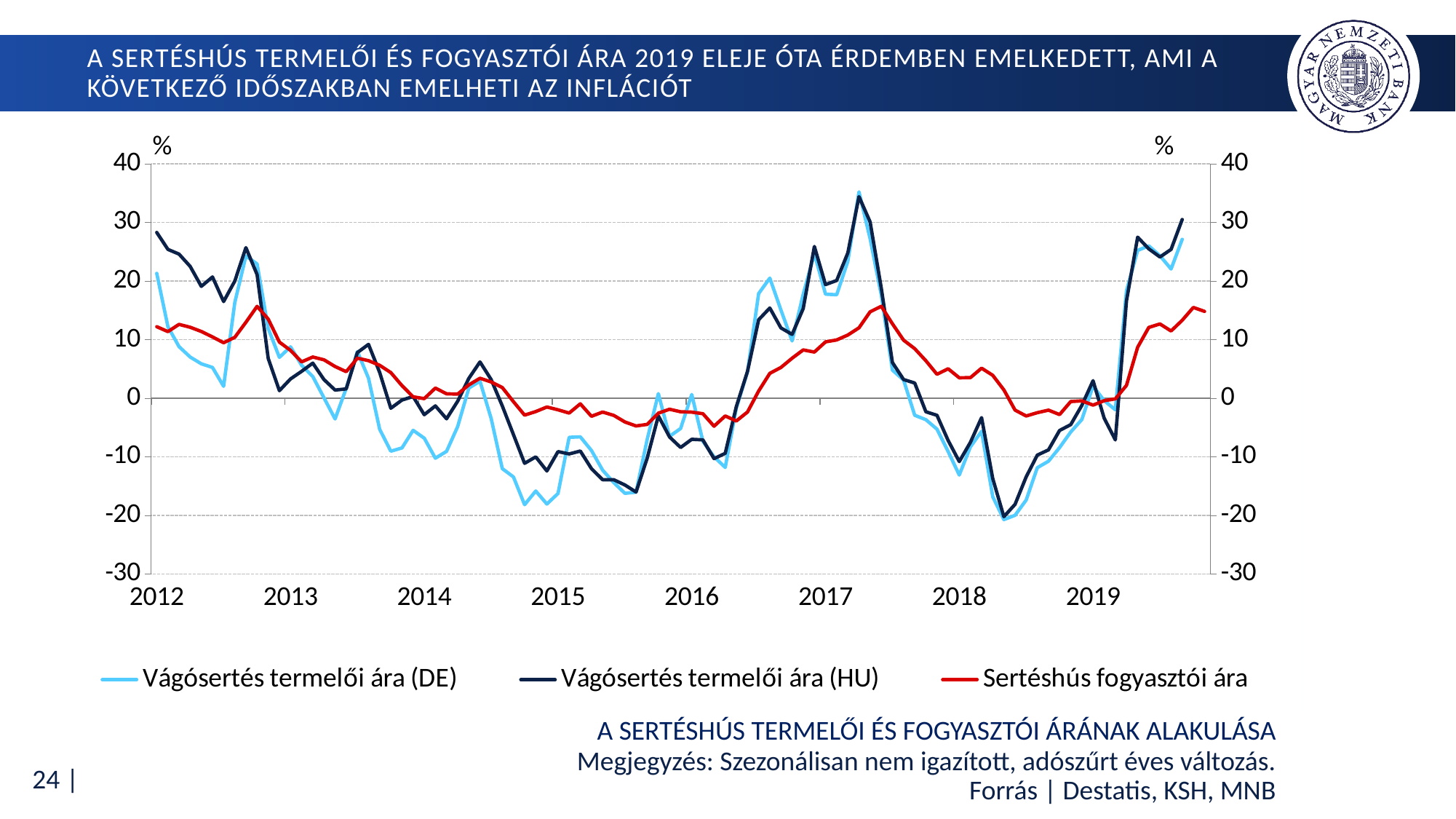
How many series does the legend list? 3 Does the Vágósertés termelői ára (HU) series rise or fall from the start of 2012 to the start of 2013? Fall Is the peak value of Sertéshús fogyasztói ára in 2017 greater or less than 10? greater What is the title of the chart? A SERTÉSHÚS TERMELŐI ÉS FOGYASZTÓI ÁRÁNAK ALAKULÁSA Which colour is used for the Sertéshús fogyasztói ára series? Red Is the lowest value of Vágósertés termelői ára (DE) in 2018 greater or less than -10? less What kind of chart is shown on the slide? Line chart How many year labels are shown on the x axis? 8 Is the value of Vágósertés termelői ára (HU) at the start of 2012 greater or less than 20? greater At the start of 2012, which is larger: Vágósertés termelői ára (HU) or Sertéshús fogyasztói ára? Vágósertés termelői ára (HU) Does the Sertéshús fogyasztói ára series rise or fall over the course of 2019? Rise